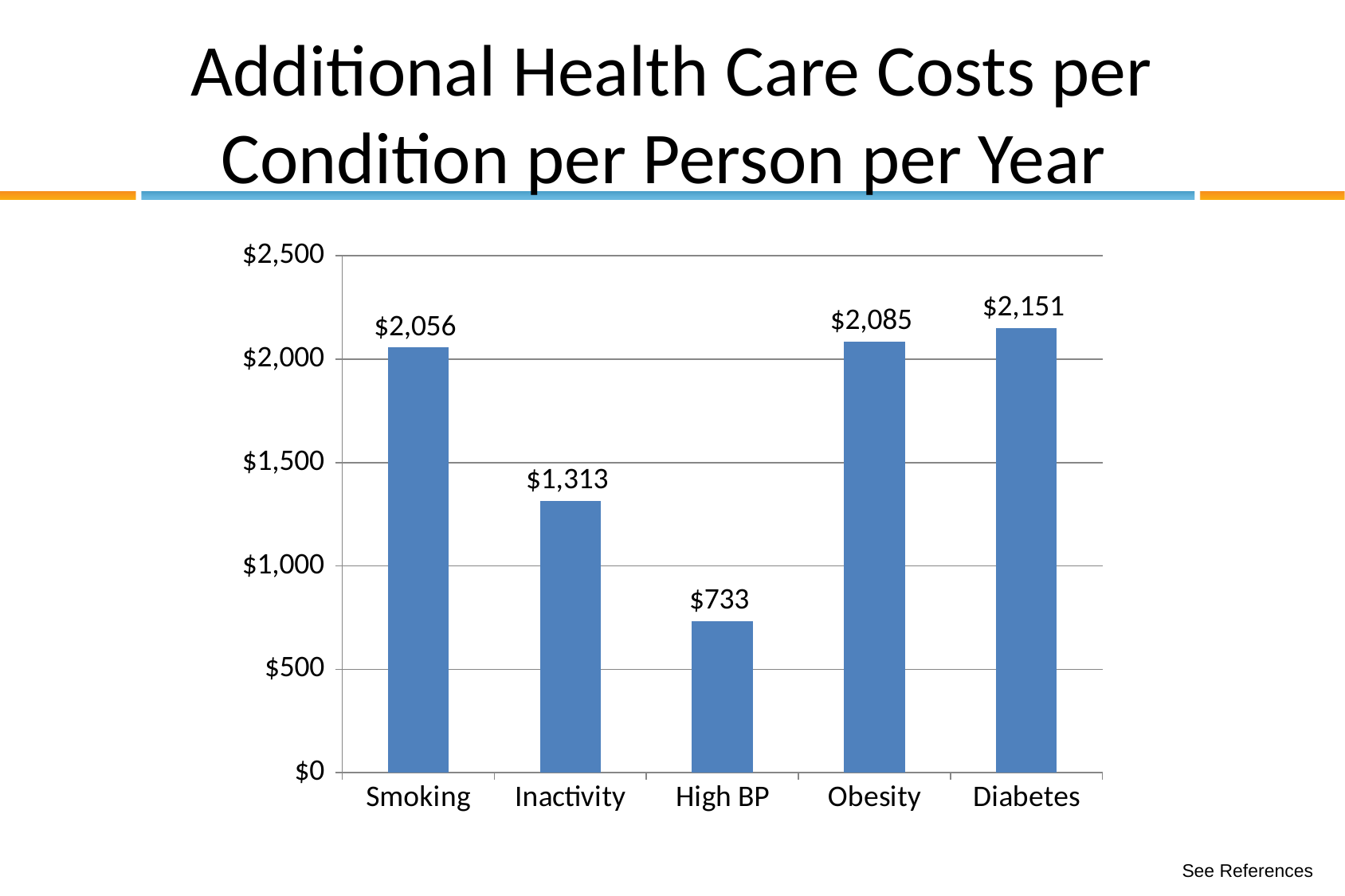
What kind of chart is shown on the slide? Bar chart Which condition has the highest additional health care cost per person per year? Diabetes How many conditions are shown on the chart? 5 What is the additional health care cost per person per year for Smoking? $2,056 Is the value for Inactivity greater or less than $1,500? less What is the additional health care cost per person per year for High BP? $733 What is the difference between the cost for Obesity and the cost for Smoking? $29 Which condition has the lowest additional health care cost per person per year? High BP Which has a higher additional health care cost, Inactivity or Obesity? Obesity What is the title of the slide? Additional Health Care Costs per Condition per Person per Year What is the difference between the cost for Diabetes and the cost for High BP? $1,418 What is the additional health care cost per person per year for Inactivity? $1,313